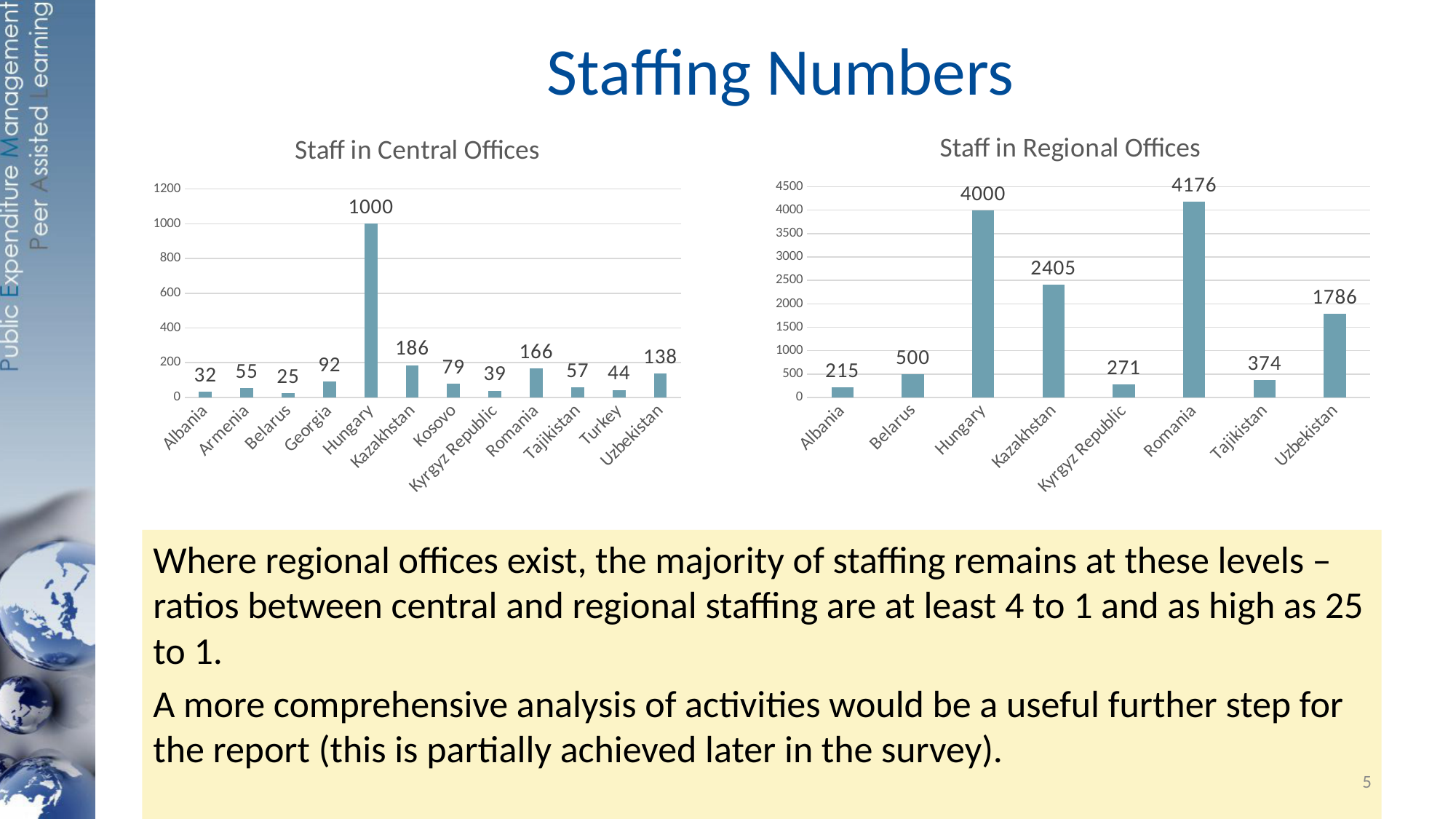
How many countries are shown in the 'Staff in Regional Offices' chart? 8 In the 'Staff in Regional Offices' chart, which country has the highest value? Romania In the 'Staff in Central Offices' chart, what is the value for Hungary? 1000 In the 'Staff in Central Offices' chart, which country has the lowest value? Belarus In the 'Staff in Regional Offices' chart, which country has the lowest value? Albania In the 'Staff in Regional Offices' chart, what is the value for Uzbekistan? 1786 In the 'Staff in Central Offices' chart, what is the difference between Romania and Uzbekistan? 28 In the 'Staff in Central Offices' chart, which is larger, the value for Georgia or the value for Kosovo? Georgia What type of chart is 'Staff in Regional Offices'? Bar chart In the 'Staff in Regional Offices' chart, what is the difference between Romania and Hungary? 176 How many countries are shown in the 'Staff in Central Offices' chart? 12 In the 'Staff in Central Offices' chart, what is the value for Kazakhstan? 186